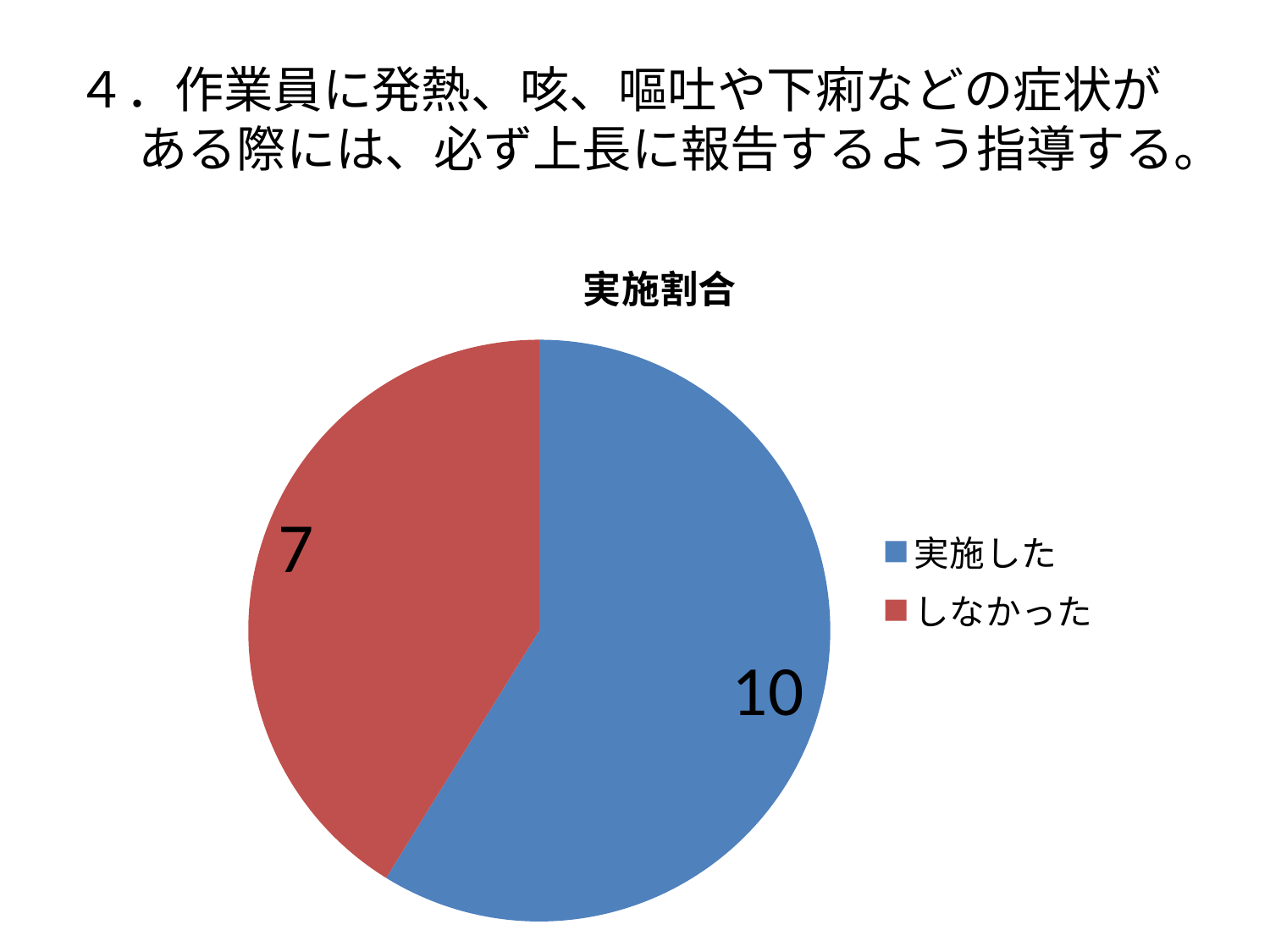
What type of chart is shown on the slide? pie chart How many slices does the pie chart have? 2 What colour is the slice for しなかった? red Which category has the smallest slice? しなかった How many entries does the legend list? 2 What is the total of all slices in the pie chart? 17 What is the value for 実施した? 10 What is the value for しなかった? 7 Which is larger, the value for 実施した or the value for しなかった? 実施した What is the difference between the values for 実施した and しなかった? 3 Which category has the largest slice? 実施した What is the title of the chart? 実施割合